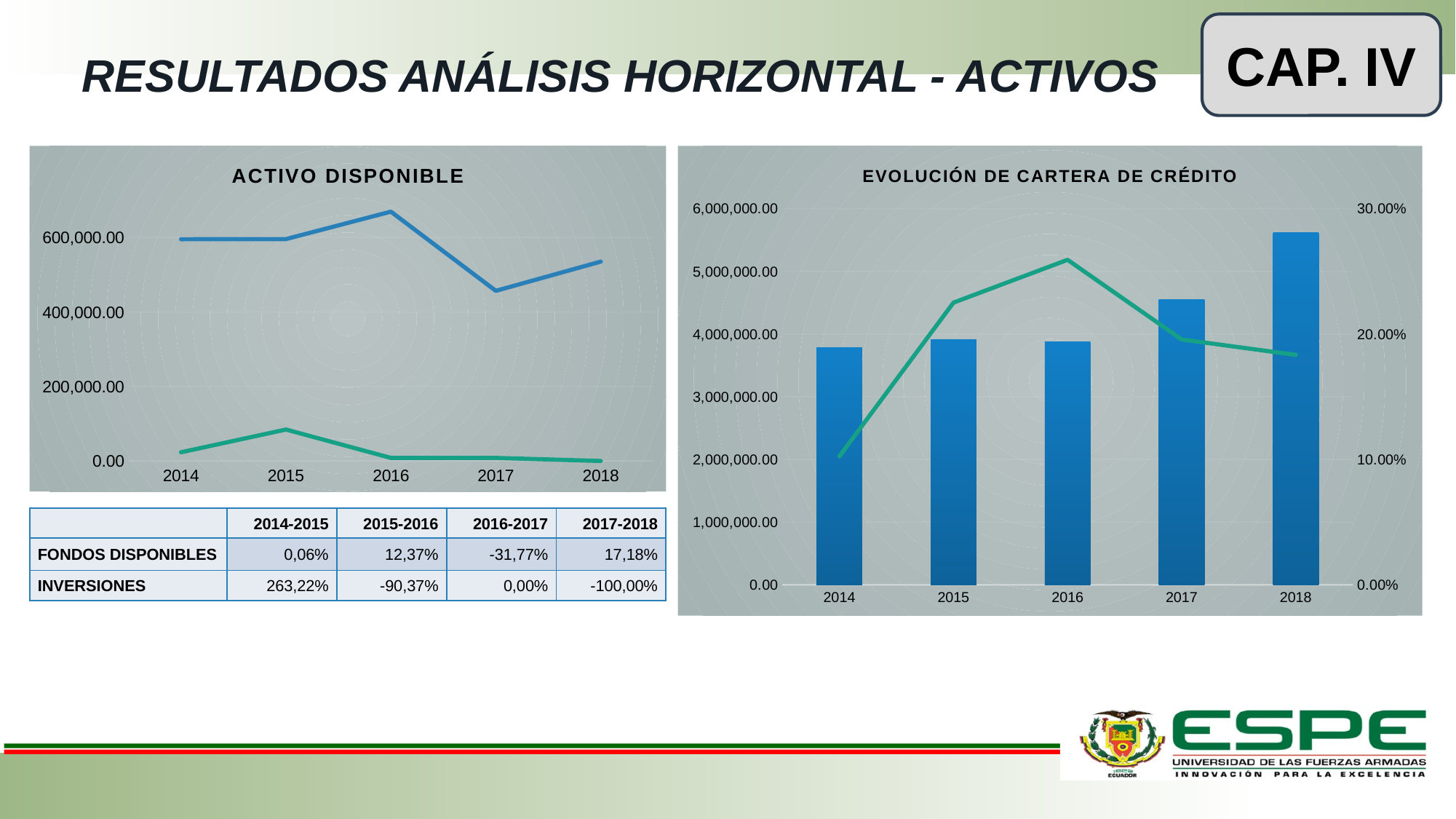
In the EVOLUCIÓN DE CARTERA DE CRÉDITO chart, in which year does the green line reach its highest point? 2016 In the EVOLUCIÓN DE CARTERA DE CRÉDITO chart, which year has the tallest bar? 2018 What kind of chart is the ACTIVO DISPONIBLE chart? Line chart In the ACTIVO DISPONIBLE chart, in which year does the lower (green) line peak? 2015 In the EVOLUCIÓN DE CARTERA DE CRÉDITO chart, is the bar for 2018 greater or less than 5,000,000.00? greater How many bars are there in the EVOLUCIÓN DE CARTERA DE CRÉDITO chart? 5 In the ACTIVO DISPONIBLE chart, is the value of the blue line in 2016 greater or less than 600,000.00? greater How many years are shown on the x axis of the ACTIVO DISPONIBLE chart? 5 In the ACTIVO DISPONIBLE chart, in which year does the upper (blue) line reach its lowest point? 2017 In the ACTIVO DISPONIBLE chart, is the value of the blue line in 2017 greater or less than 600,000.00? less What kind of chart is the EVOLUCIÓN DE CARTERA DE CRÉDITO chart? Combined bar and line chart